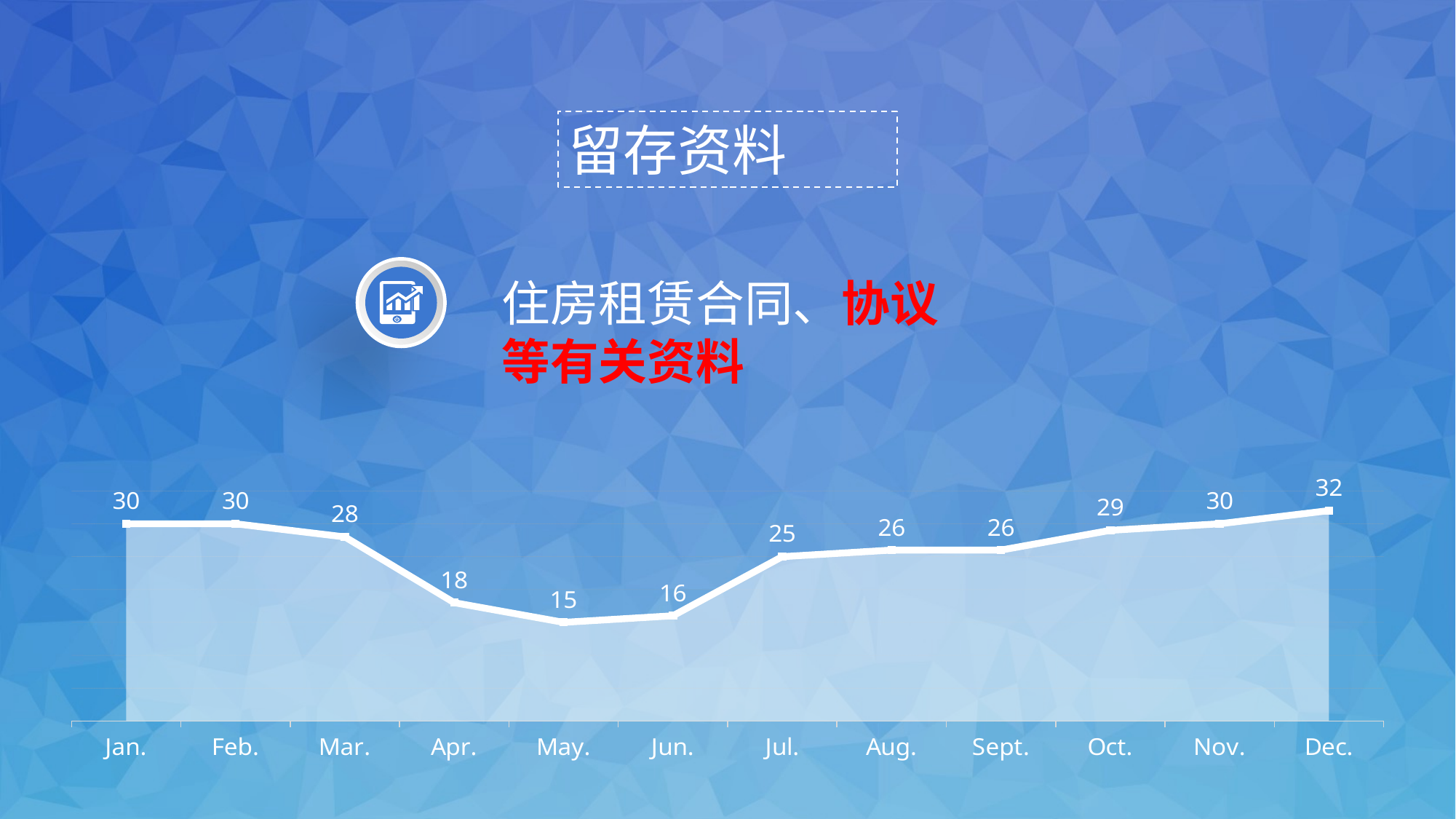
What is the value for Mar.? 28 What is the value for Oct.? 29 What kind of chart is shown on the slide? Area chart What is the value for Jul.? 25 Which is larger, the value for Jun. or the value for Aug.? Aug. How many months are plotted on the x axis? 12 Which month has the highest value? Dec. What is the difference between the values for Mar. and Apr.? 10 Do the values rise or fall from Feb. to May.? Fall Which month has the lowest value? May. What is the difference between the values for Dec. and May.? 17 Do the values rise or fall from Jul. to Dec.? Rise